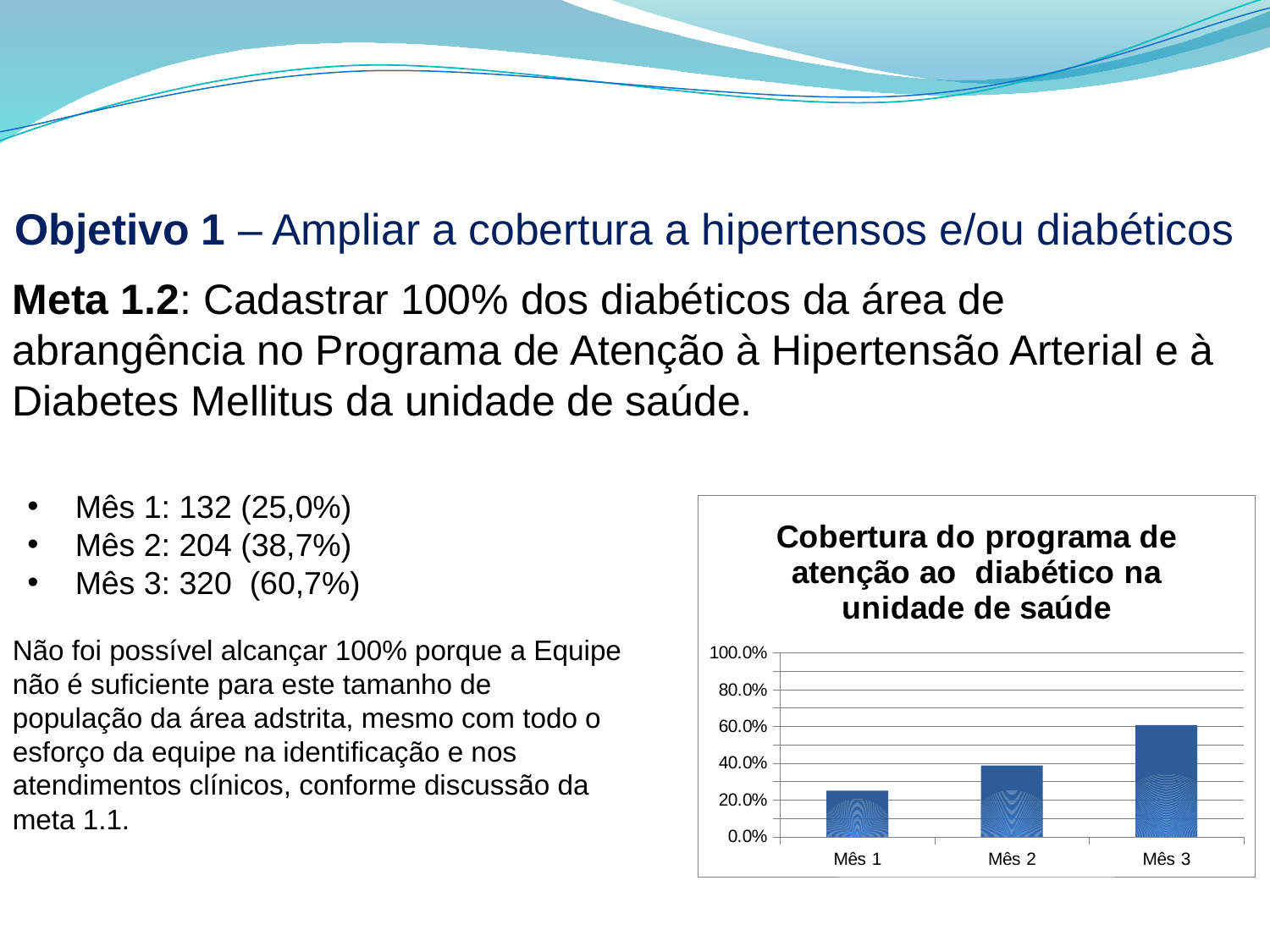
How many categories are shown on the x axis of the chart? 3 Do the values rise or fall from Mês 1 to Mês 3? rise What kind of chart is shown on the slide? bar chart Is the value for Mês 2 greater or less than 20.0%? greater What is the highest tick value shown on the y axis of the chart? 100.0% Is the value for Mês 3 greater or less than 80.0%? less Which month has the lowest bar in the chart? Mês 1 Which month has the highest bar in the chart? Mês 3 Is the value for Mês 3 greater or less than 40.0%? greater What is the title of the chart? Cobertura do programa de atenção ao diabético na unidade de saúde Which is larger, the bar for Mês 2 or the bar for Mês 3? Mês 3